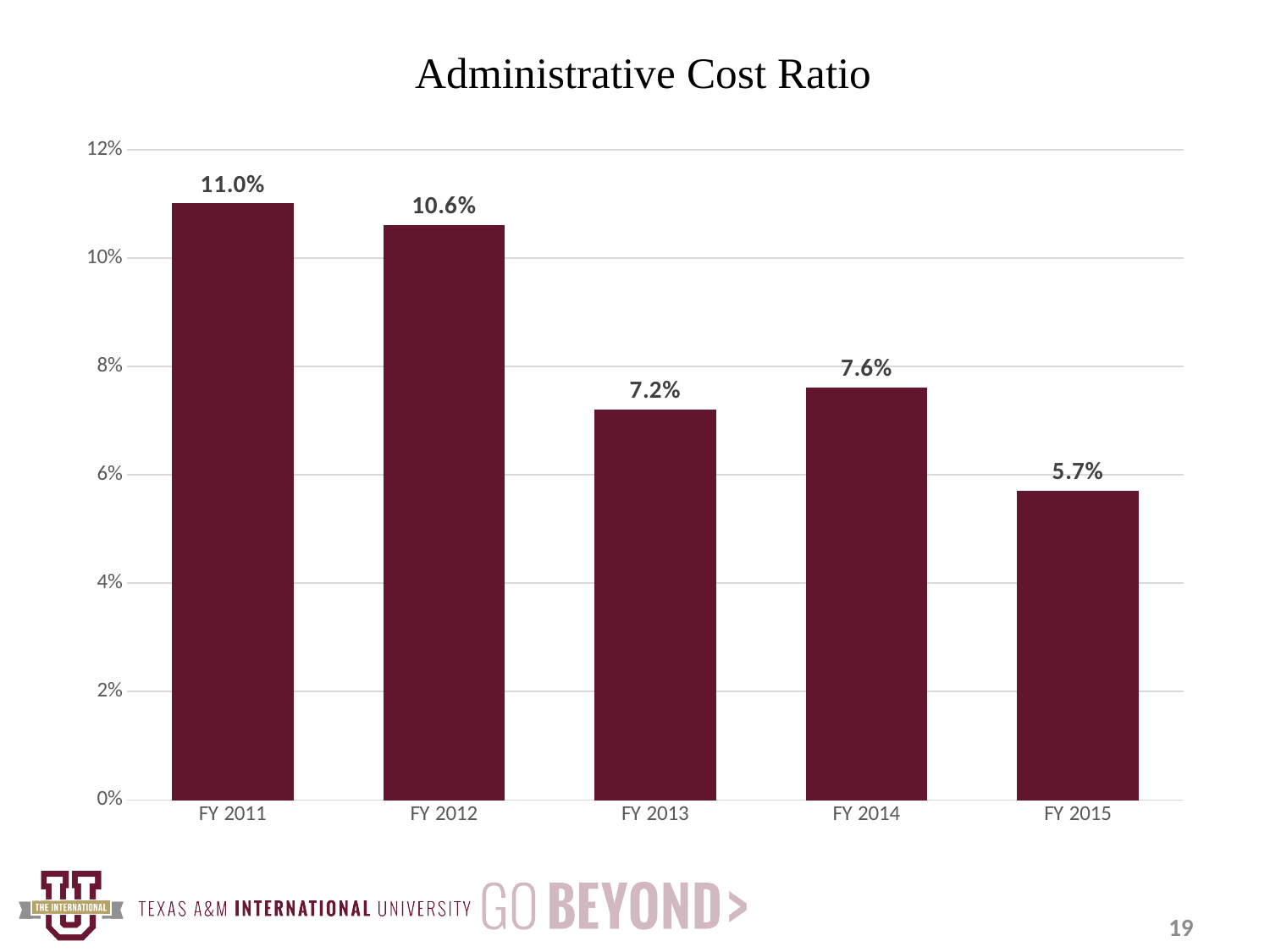
Which fiscal year has the lowest Administrative Cost Ratio? FY 2015 How many fiscal years are shown on the chart? 5 What is the difference between the Administrative Cost Ratio in FY 2014 and FY 2013? 0.4% What kind of chart is shown on the slide? bar chart What is the title of the chart? Administrative Cost Ratio Is the value for FY 2014 greater or less than 8%? less Which fiscal year has the highest Administrative Cost Ratio? FY 2011 What is the Administrative Cost Ratio for FY 2013? 7.2% Which is larger, the Administrative Cost Ratio for FY 2012 or FY 2014? FY 2012 What is the Administrative Cost Ratio for FY 2011? 11.0% What is the difference between the Administrative Cost Ratio in FY 2011 and FY 2015? 5.3% What is the Administrative Cost Ratio for FY 2015? 5.7%